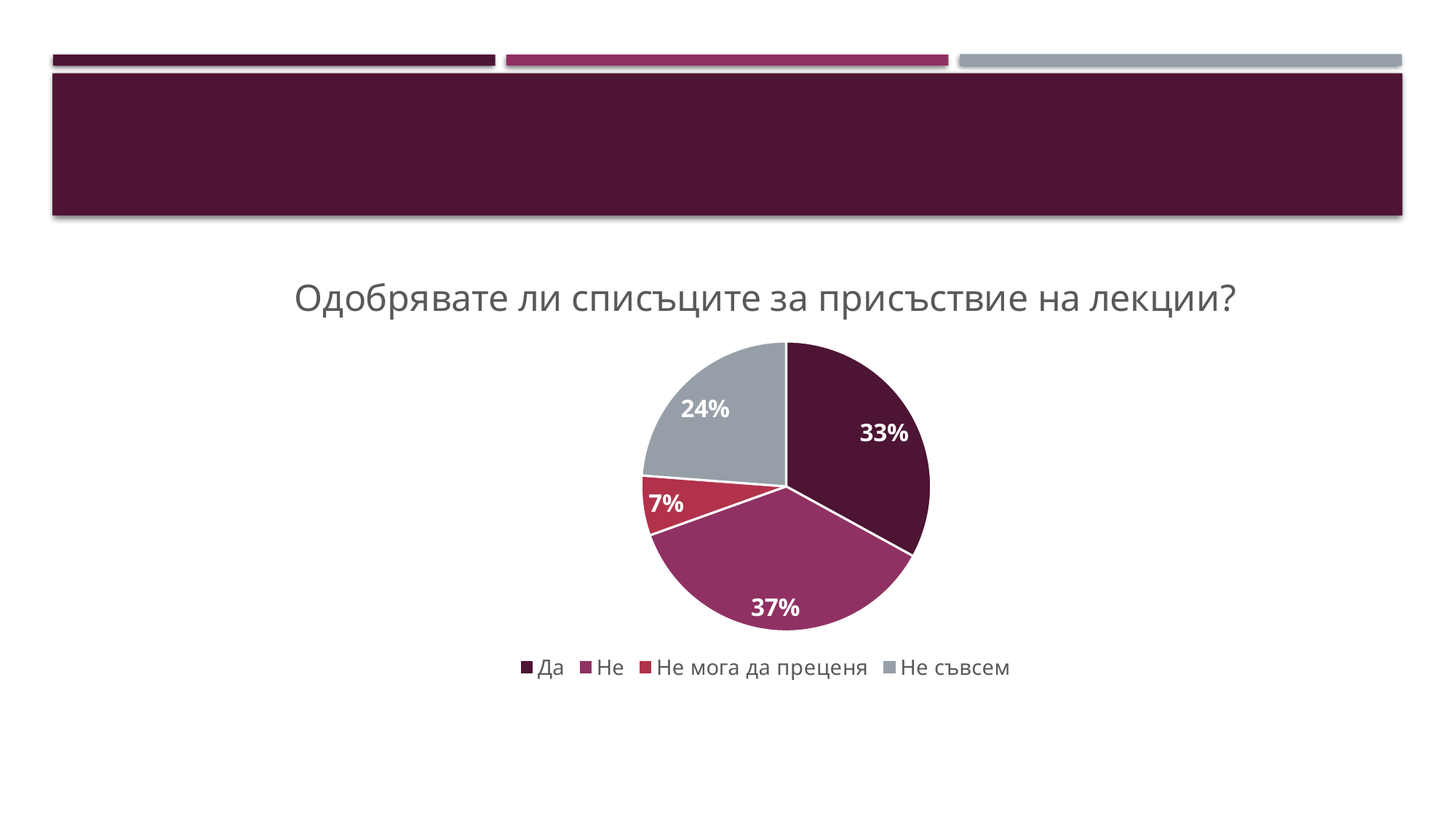
What kind of chart is shown on the slide? Pie chart Which category has the largest slice of the pie? Не Which category has the smallest slice of the pie? Не мога да преценя What share of the pie does "Не мога да преценя" represent? 7% What is the difference in percentage points between "Не" and "Да"? 4% Which is larger, the slice for "Да" or the slice for "Не съвсем"? Да What share of the pie does "Не съвсем" represent? 24% What is the difference in percentage points between "Не съвсем" and "Не мога да преценя"? 17% What share of the pie does "Не" represent? 37% How many categories does the pie chart show? 4 What is the title of the chart? Одобрявате ли списъците за присъствие на лекции?